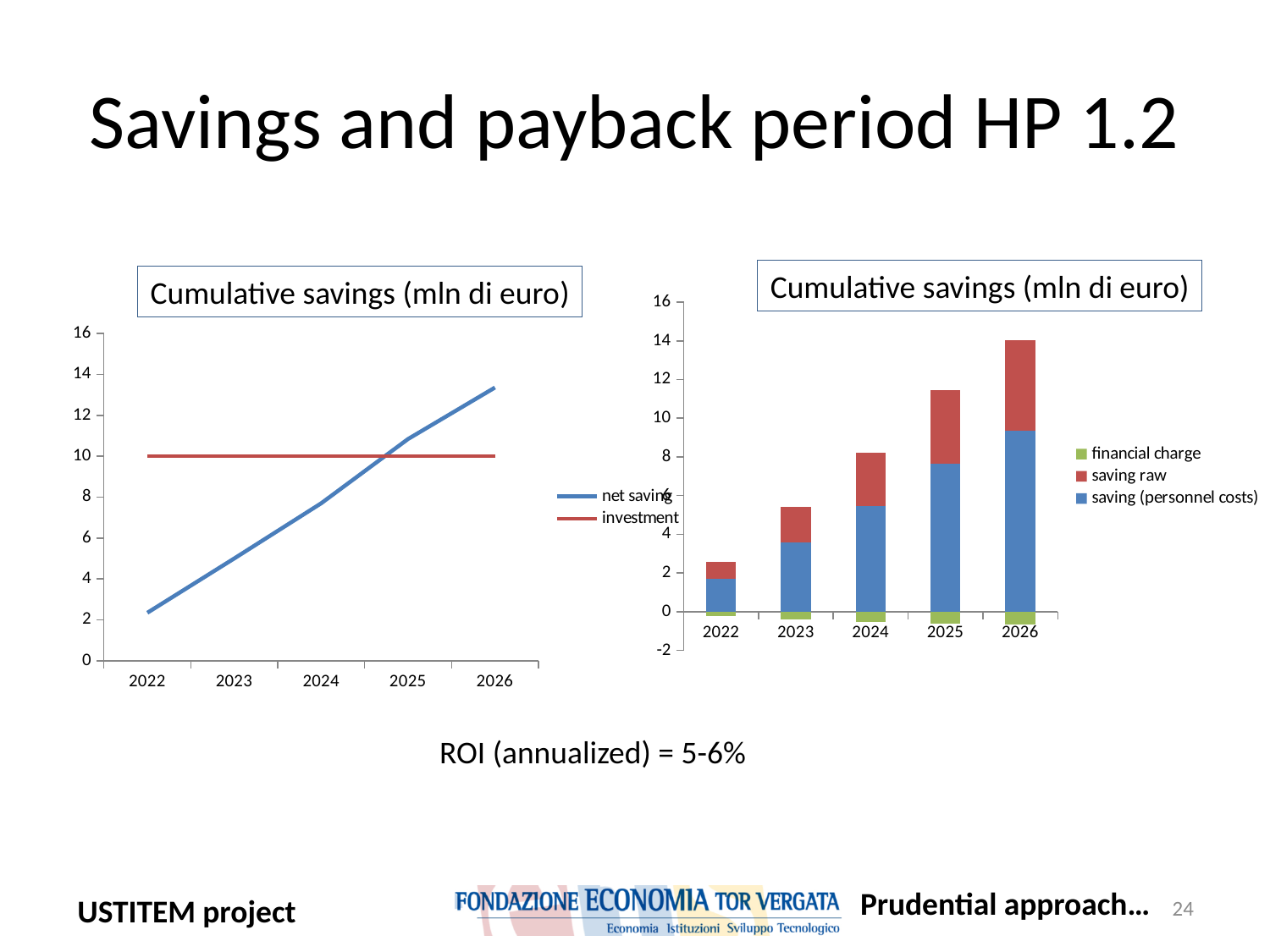
What kind of chart is the right chart on the slide? bar chart In the left chart, is the net saving value for 2026 greater or less than 12? greater In the right chart, which year has the tallest stacked bar? 2026 In the left chart, is the net saving value for 2022 greater or less than 4? less How many years are shown on the x axis of the right chart? 5 In the right chart, which series is shown in green in the legend? financial charge What kind of chart is the left chart on the slide? line chart In the left chart, which is larger in 2026, net saving or investment? net saving How many series does the legend of the right chart list? 3 In the right chart, which year has the shortest stacked bar? 2022 In the left chart, does the net saving line rise or fall from 2022 to 2026? rises How many series does the legend of the left chart list? 2